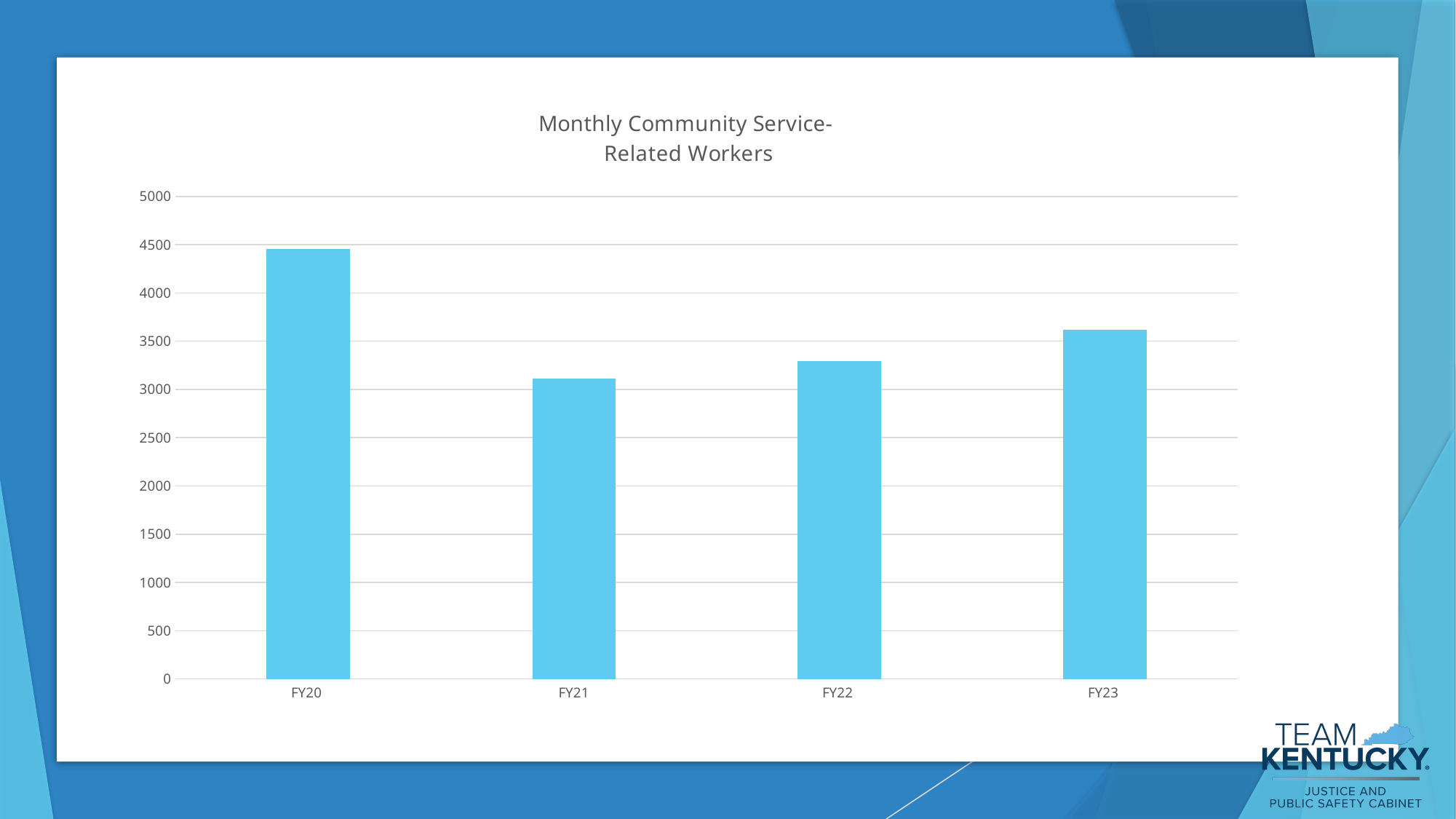
What kind of chart is shown on the slide? bar chart Is the value for FY20 greater or less than 4000? greater How many fiscal years are shown on the x axis? 4 Is the value for FY21 greater or less than 3500? less Do the values rise or fall from FY21 to FY23? rise Which fiscal year has the lowest number of monthly community service-related workers? FY21 Which is larger, the value for FY20 or the value for FY21? FY20 Is the value for FY23 greater or less than 4000? less Which is larger, the value for FY22 or the value for FY23? FY23 Which fiscal year has the highest number of monthly community service-related workers? FY20 What is the title of the chart? Monthly Community Service-Related Workers